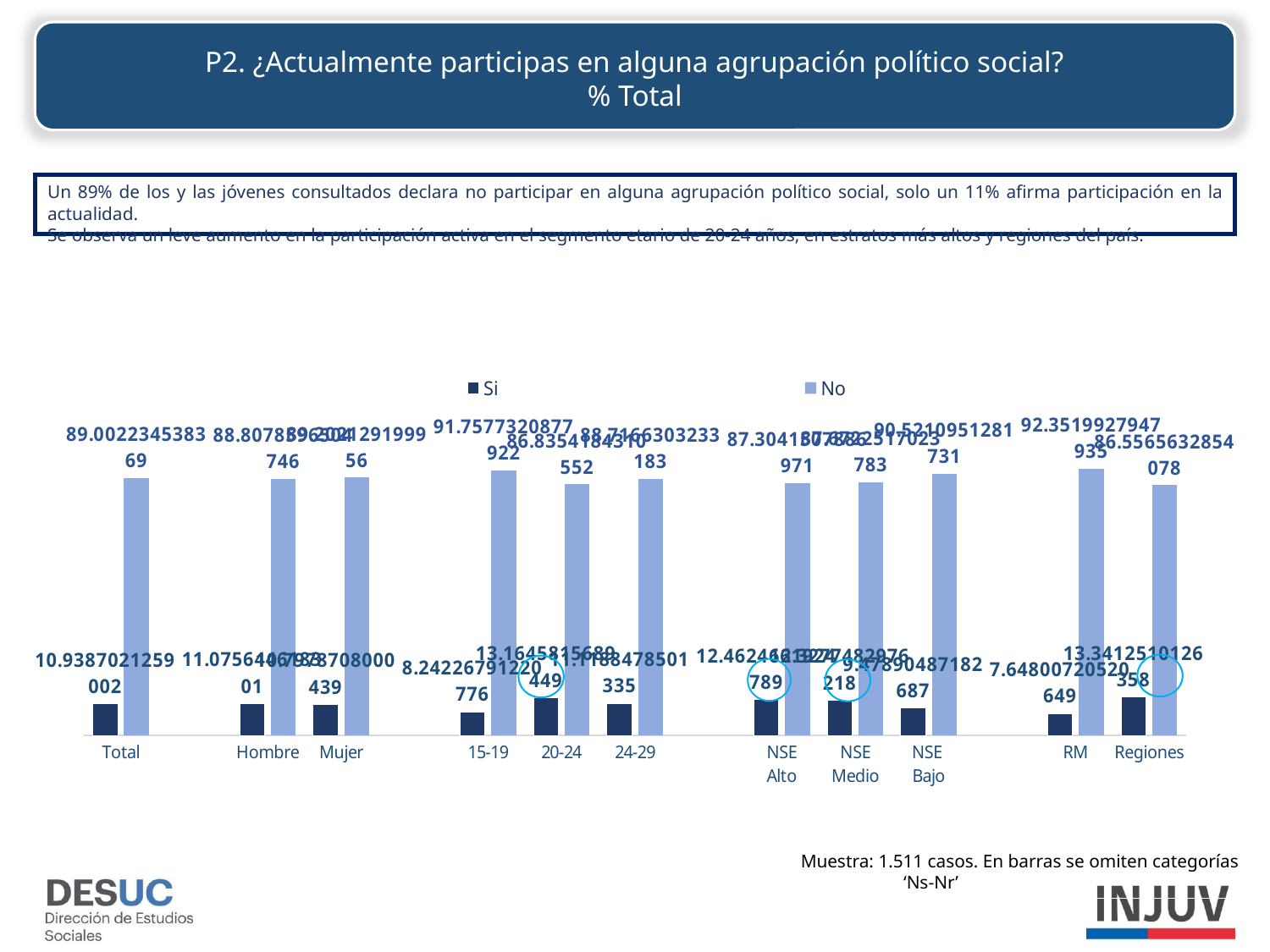
What kind of chart is shown on the slide? bar chart What are the two series named in the chart legend? Si and No Which has the larger No value, 15-19 or 24-29? 15-19 For the Total category, which is larger, the Si bar or the No bar? No Which has the larger Si value, 15-19 or 20-24? 20-24 Which category has the highest value for the No series? RM How many series does the chart legend list? 2 How many categories are shown along the x axis of the chart? 11 Which category has the lowest value for the Si series? RM What is the No value for RM as printed on the chart? 92.3519927947935 What is the title of the chart on the slide? P2. ¿Actualmente participas en alguna agrupación político social? % Total